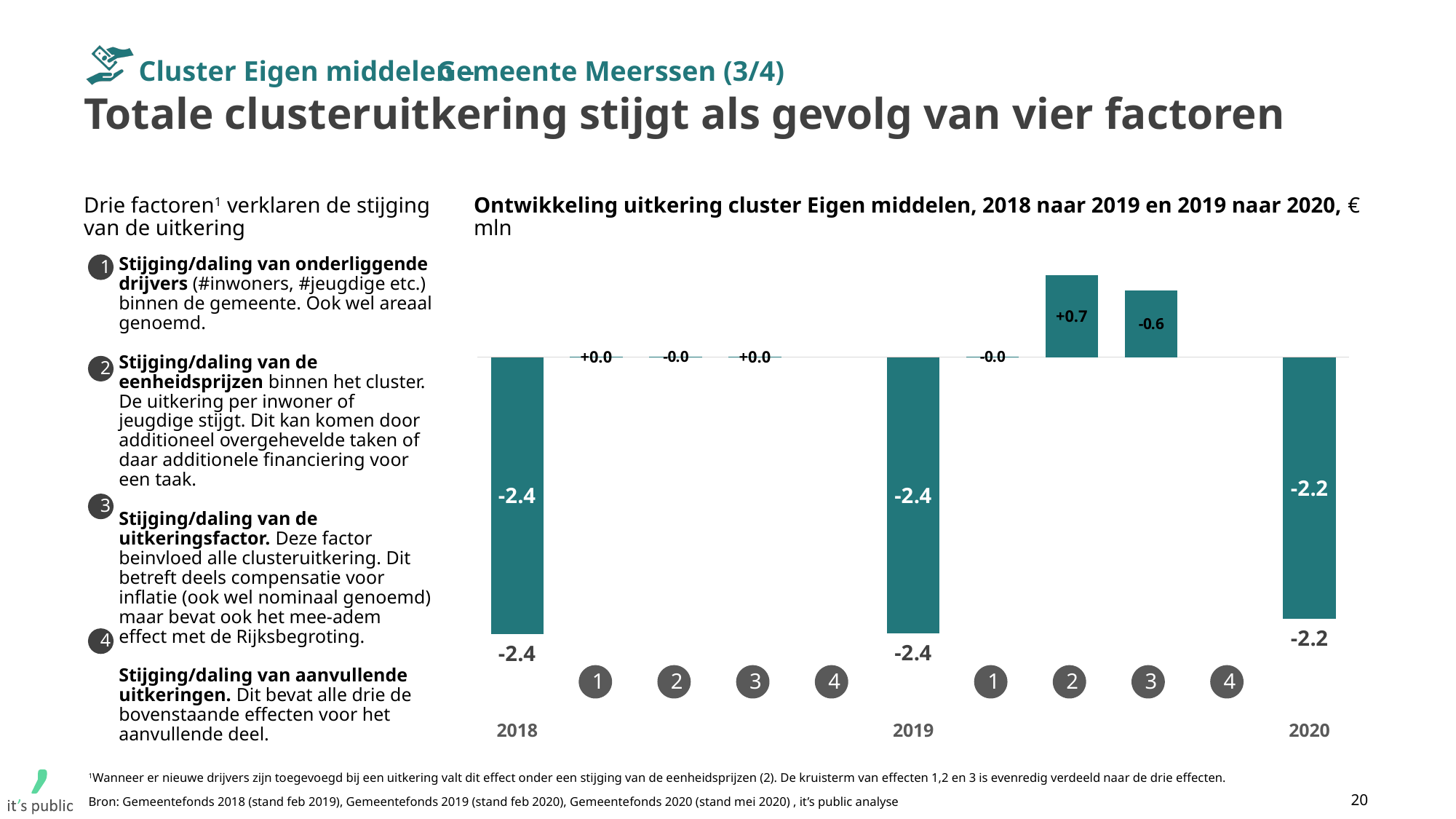
What type of chart is shown on the slide? bar chart Which of the three year bars (2018, 2019, 2020) has the highest value? 2020 What is the value of factor 3 in the step from 2019 to 2020? -0.6 How many year bars (2018, 2019, 2020) are shown in the chart? 3 What is the value of the 2019 bar in the chart? -2.4 In the step from 2019 to 2020, which is larger: the value for factor 2 or the value for factor 3? factor 2 What is the difference between the 2020 value and the 2019 value? 0.2 What is the title of the chart? Ontwikkeling uitkering cluster Eigen middelen, 2018 naar 2019 en 2019 naar 2020, € mln What is the value of the 2020 bar in the chart? -2.2 What is the value of factor 1 in the step from 2018 to 2019? +0.0 What is the value of the 2018 bar in the chart? -2.4 What is the value of factor 2 in the step from 2019 to 2020? +0.7